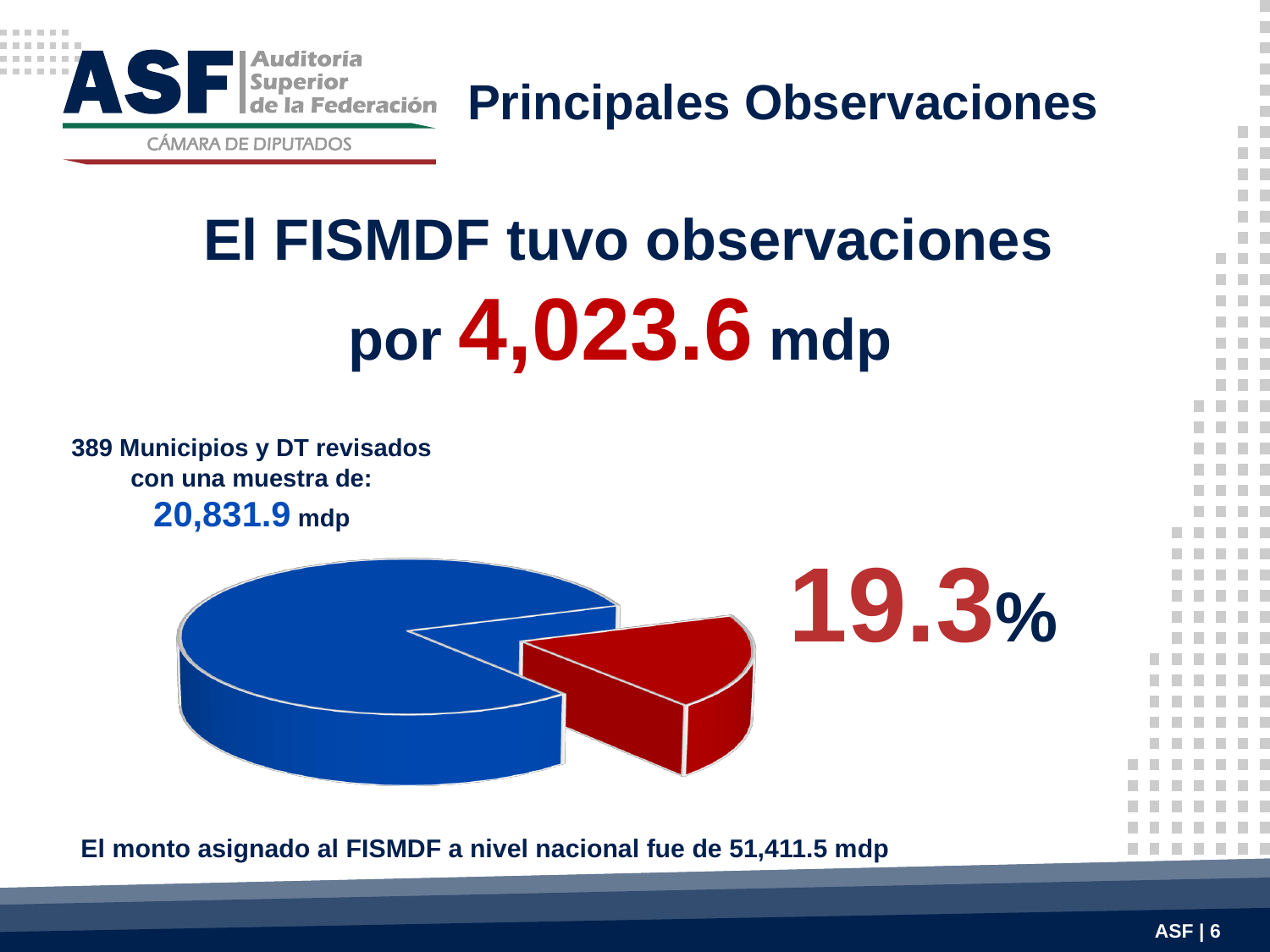
What share of the pie does the blue slice represent, given the red slice is 19.3%? 80.7% Which slice of the pie chart is larger, the blue one or the red one? blue What colour is the slice that is pulled out from the rest of the pie chart? red What percentage is shown next to the red slice of the pie chart? 19.3% Does the pie chart have a legend? No What kind of chart is shown on the slide? pie chart Which slice of the pie chart is the largest? the blue slice Which slice of the pie chart is the smallest? the red slice How many slices does the pie chart have? 2